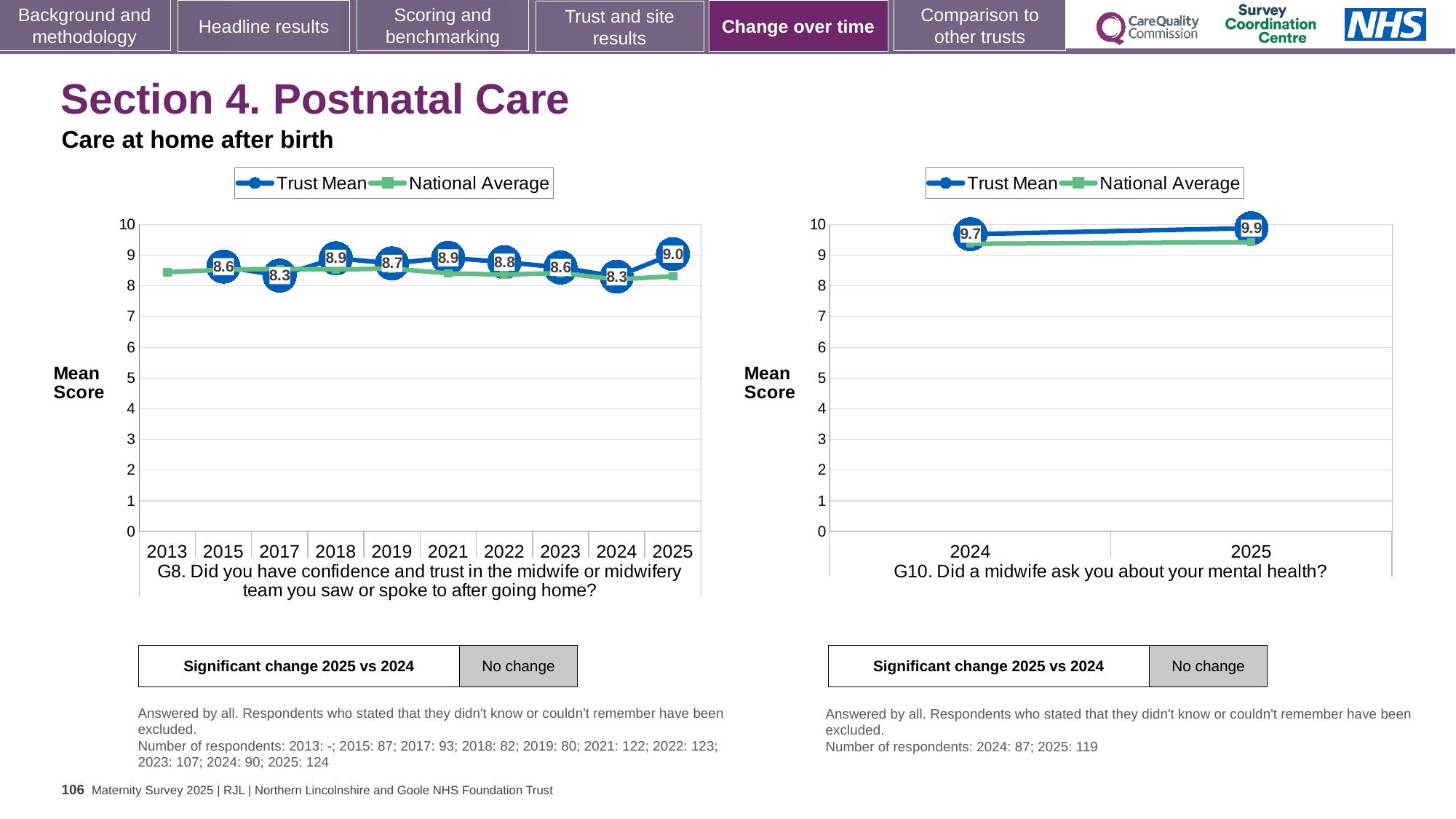
What kind of chart is the G10 chart on the right? Line chart In the G8 chart on the left, is the National Average for 2013 greater or less than 9? less How many years are shown on the x axis of the G8 chart on the left? 10 In the G10 chart on the right, does the Trust Mean rise or fall from 2024 to 2025? Rise In the G8 chart on the left, what is the difference between the Trust Mean for 2025 and 2024? 0.7 How many series does the legend of the G10 chart on the right list? 2 In the G8 chart on the left, what is the Trust Mean for 2017? 8.3 In the G8 chart on the left, what is the Trust Mean for 2025? 9.0 In the G10 chart on the right, what is the Trust Mean for 2024? 9.7 In the G10 chart on the right, what is the difference between the Trust Mean for 2025 and 2024? 0.2 In the G8 chart on the left, which is larger: the Trust Mean for 2018 or for 2019? 2018 In the G8 chart on the left, which year has the highest Trust Mean? 2025